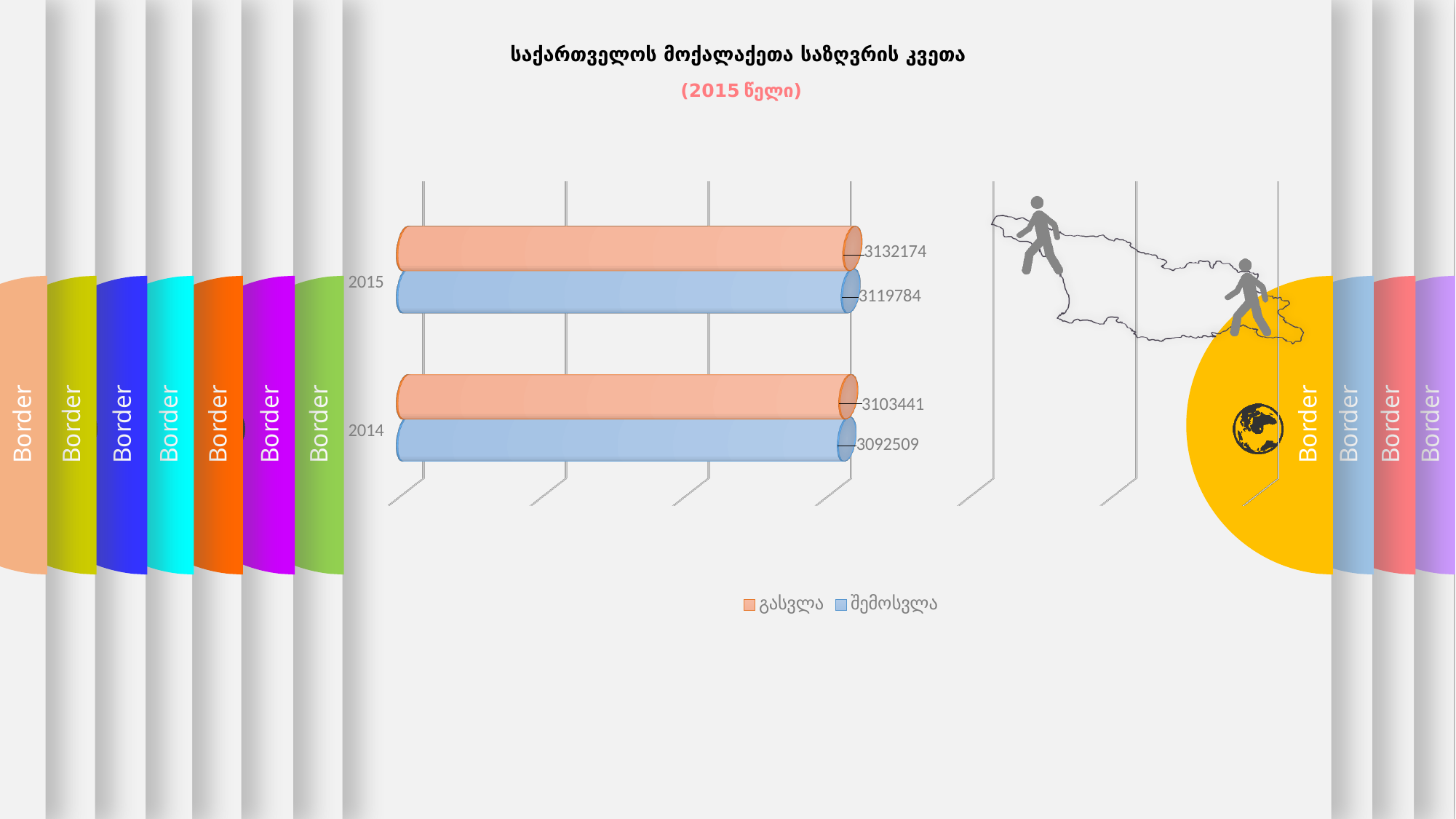
What is the difference between გასვლა in 2015 and გასვლა in 2014? 28733 Which year has the lower value for შემოსვლა? 2014 What is the value of შემოსვლა for 2014? 3092509 In 2014, which is larger: გასვლა or შემოსვლა? გასვლა What is the value of შემოსვლა for 2015? 3119784 How many years are shown on the chart? 2 What is the value of გასვლა for 2015? 3132174 What type of chart is shown on the slide? bar chart What is the difference between გასვლა and შემოსვლა in 2015? 12390 How many series does the legend list? 2 What is the value of გასვლა for 2014? 3103441 Which year has the higher value for გასვლა? 2015